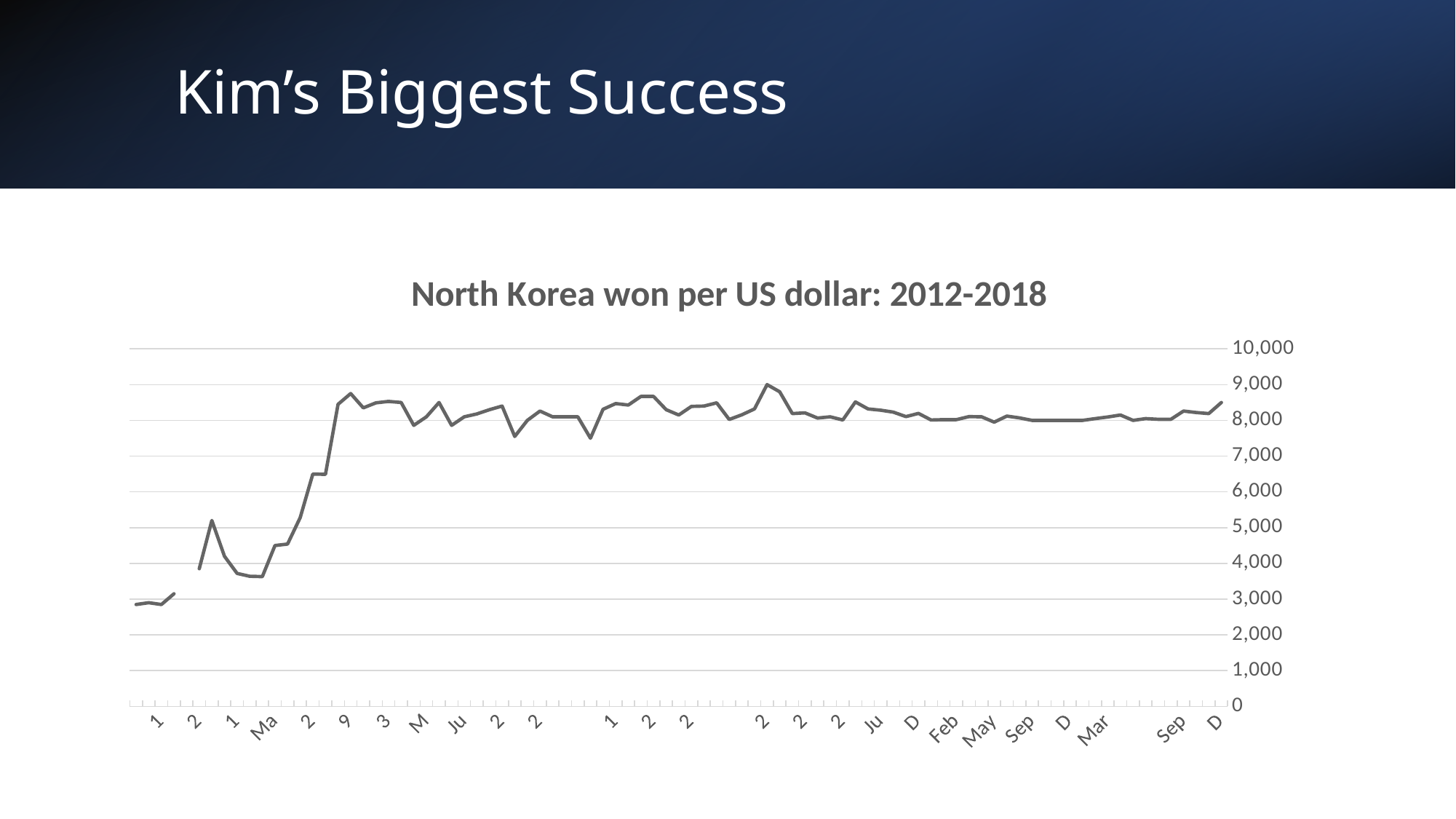
Is the value at the last point of the line (labelled D) greater or less than 8,000? greater What kind of chart is shown on the slide? line chart What is the title of the chart? North Korea won per US dollar: 2012-2018 How many lines are plotted on the chart? 1 What is the highest value shown on the vertical axis of the chart? 10,000 Is the highest point on the line greater or less than 8,000? greater Is the lowest point on the line greater or less than 2,000? greater Overall, does the line rise or fall from the start of the x axis to the end? rises